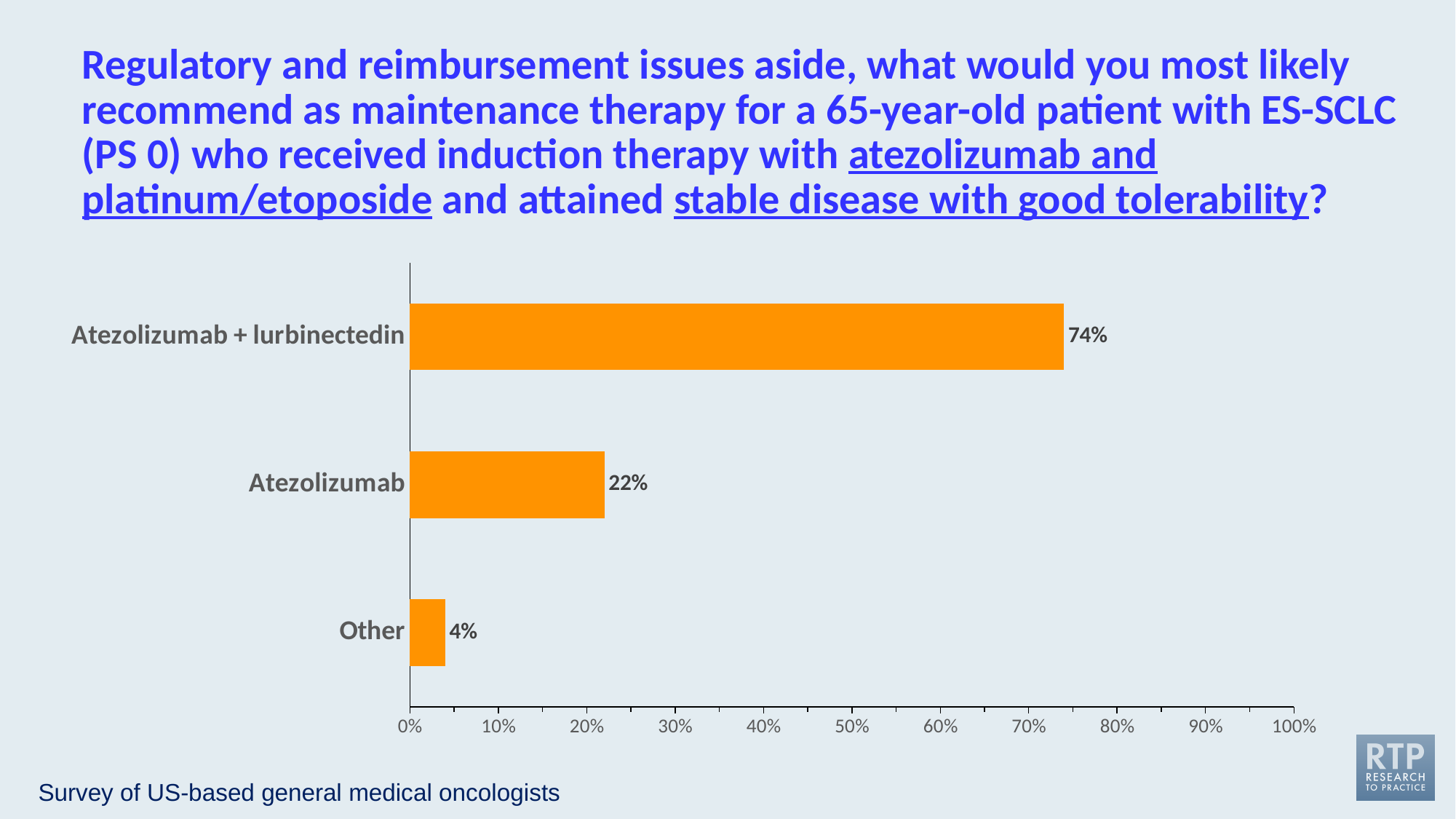
What is the difference in percentage points between atezolizumab + lurbinectedin and atezolizumab alone? 52 What percentage of respondents would recommend atezolizumab + lurbinectedin? 74% Is the value for atezolizumab + lurbinectedin greater or less than 70%? greater What is the difference in percentage points between atezolizumab alone and Other? 18 What is the maximum value shown on the horizontal axis? 100% How many response options are shown in the chart? 3 What percentage of respondents chose Other? 4% What percentage of respondents would recommend atezolizumab alone? 22% Which has a larger share of respondents, atezolizumab alone or Other? Atezolizumab What kind of chart is shown on the slide? Bar chart Which option has the lowest percentage of respondents? Other Which option has the highest percentage of respondents? Atezolizumab + lurbinectedin